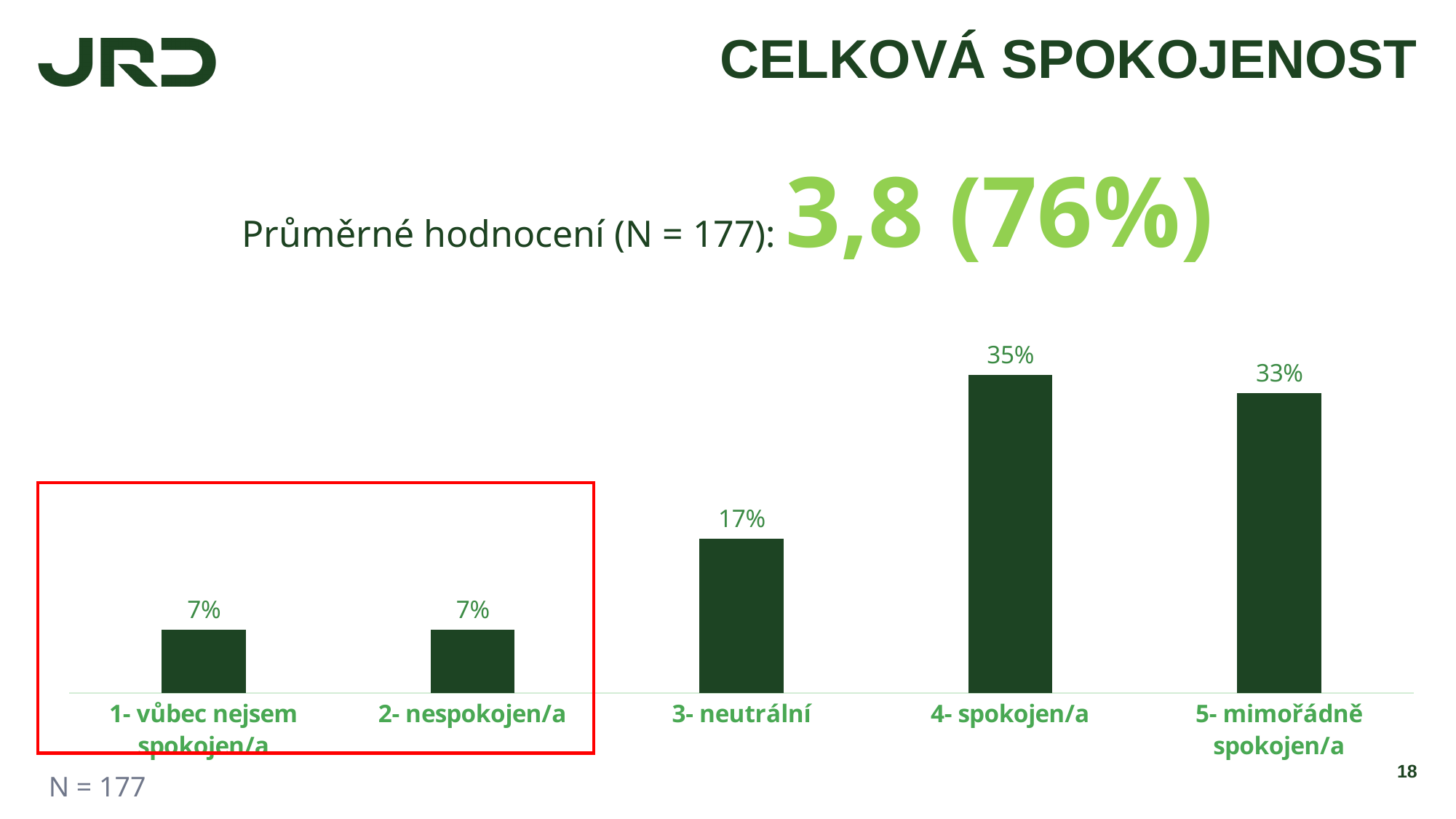
What is the difference between the values for "4- spokojen/a" and "3- neutrální"? 18% What is the difference between the values for "5- mimořádně spokojen/a" and "1- vůbec nejsem spokojen/a"? 26% Which is larger, the value for "3- neutrální" or the value for "5- mimořádně spokojen/a"? 5- mimořádně spokojen/a What is the average rating (Průměrné hodnocení) shown on the slide? 3,8 (76%) What is the value for the category "3- neutrální"? 17% How many categories are shown in the chart? 5 What is the value for the category "5- mimořádně spokojen/a"? 33% What kind of chart is shown on the slide? bar chart What is the combined value of the two categories inside the red box ("1- vůbec nejsem spokojen/a" and "2- nespokojen/a")? 14% What is the value for the category "2- nespokojen/a"? 7% What is the value for the category "4- spokojen/a"? 35% Which category has the highest value? 4- spokojen/a